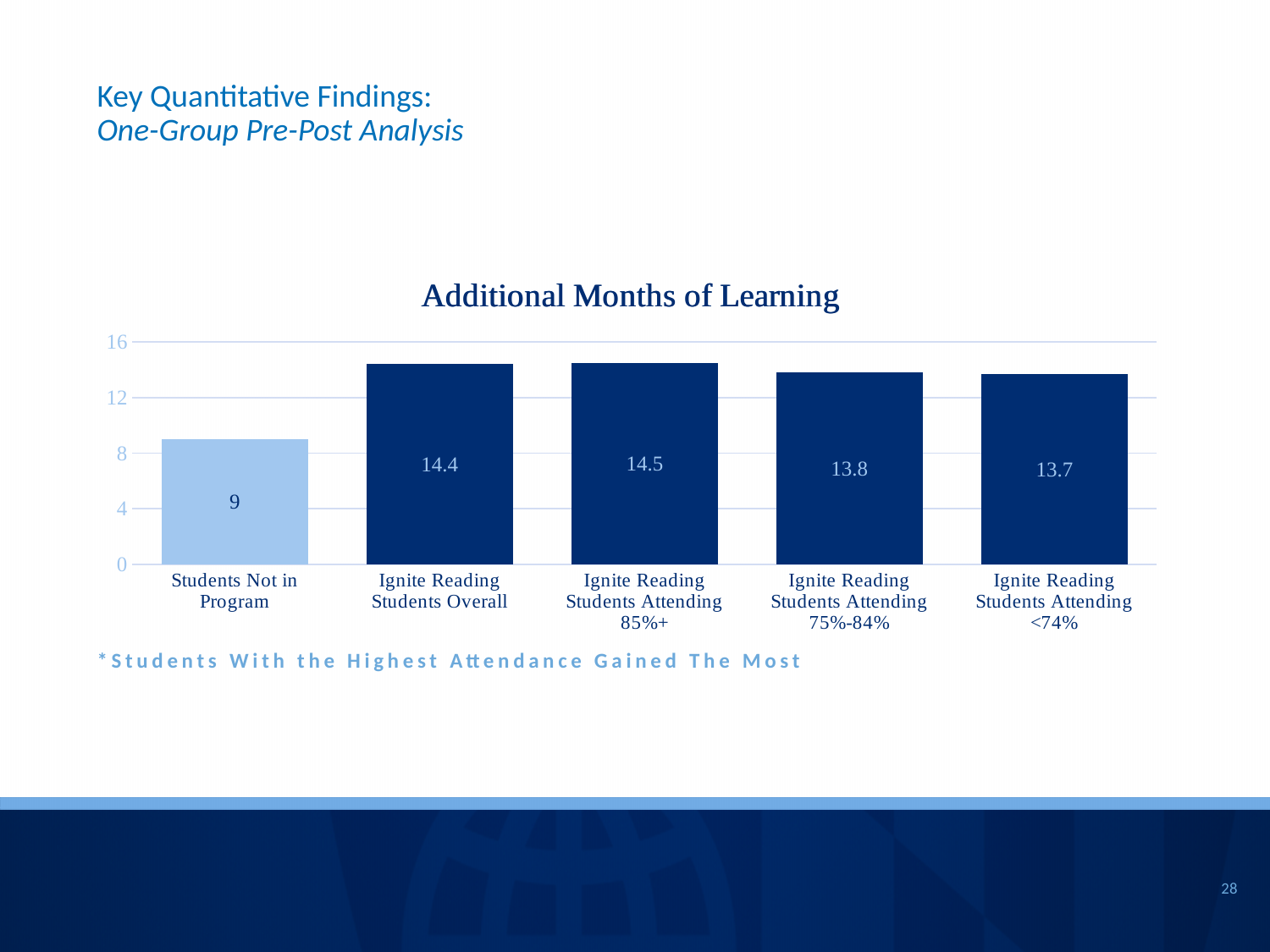
What kind of chart is shown on the slide? Bar chart How many categories are shown in the chart? 5 What is the value for Ignite Reading Students Attending 85%+? 14.5 What is the title of the chart? Additional Months of Learning Which is larger: the value for Ignite Reading Students Attending 75%-84% or Students Not in Program? Ignite Reading Students Attending 75%-84% What is the difference between Ignite Reading Students Attending 85%+ and Ignite Reading Students Attending <74%? 0.8 What is the value for Ignite Reading Students Attending <74%? 13.7 What is the value for Students Not in Program? 9 What is the difference between Ignite Reading Students Overall and Students Not in Program? 5.4 What is the value for Ignite Reading Students Overall? 14.4 Which category has the lowest value? Students Not in Program Which category has the highest value? Ignite Reading Students Attending 85%+